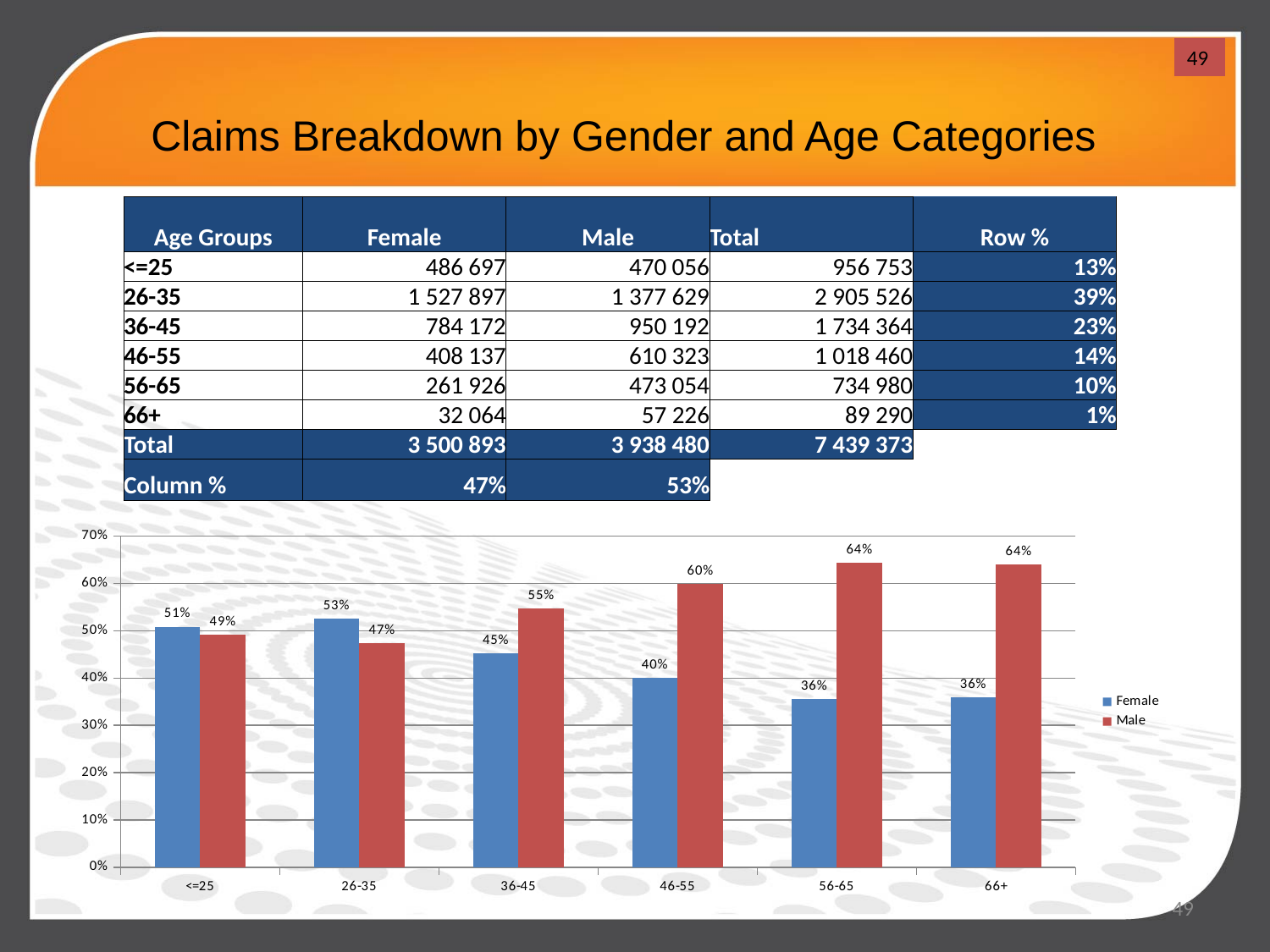
Which colour represents the Male series in the chart? red What is the Female value for the <=25 age group in the chart? 51% How many age group categories are shown on the chart's x axis? 6 What kind of chart is shown on the slide? bar chart How does the Female value change across the age groups from <=25 to 66+ in the chart? It generally falls What is the Male value for the 46-55 age group in the chart? 60% In the chart, which is larger for the 26-35 age group, the Female value or the Male value? Female Which age group has the lowest Male value in the chart? 26-35 What is the Female value for the 36-45 age group in the chart? 45% Which age group has the highest Female value in the chart? 26-35 What is the difference between the Male and Female values for the 56-65 age group in the chart? 28% How many series does the chart legend list? 2